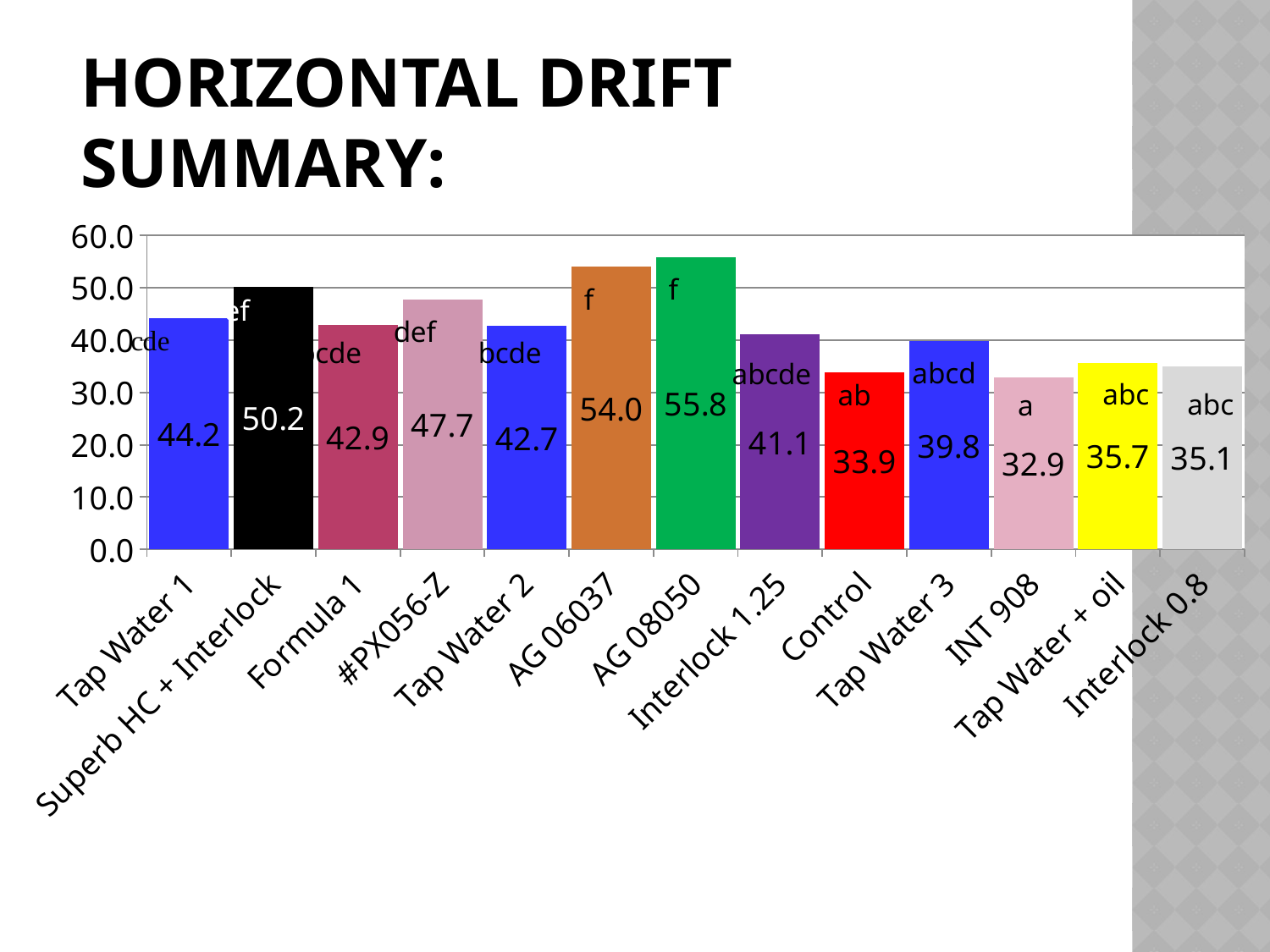
Which category has the lowest value? INT 908 How many categories are shown on the x axis? 13 What is the value for Tap Water + oil? 35.7 What is the value for Control? 33.9 What is the value for AG 06037? 54.0 Which category has the highest value? AG 08050 What kind of chart is shown on the slide? bar chart Which is larger, the value for Tap Water 1 or the value for Interlock 1.25? Tap Water 1 What is the value for Superb HC + Interlock? 50.2 What is the difference between the values for AG 08050 and INT 908? 22.9 What is the difference between the values for #PX056-Z and Tap Water 3? 7.9 Is the value for Interlock 0.8 greater or less than 40.0? less